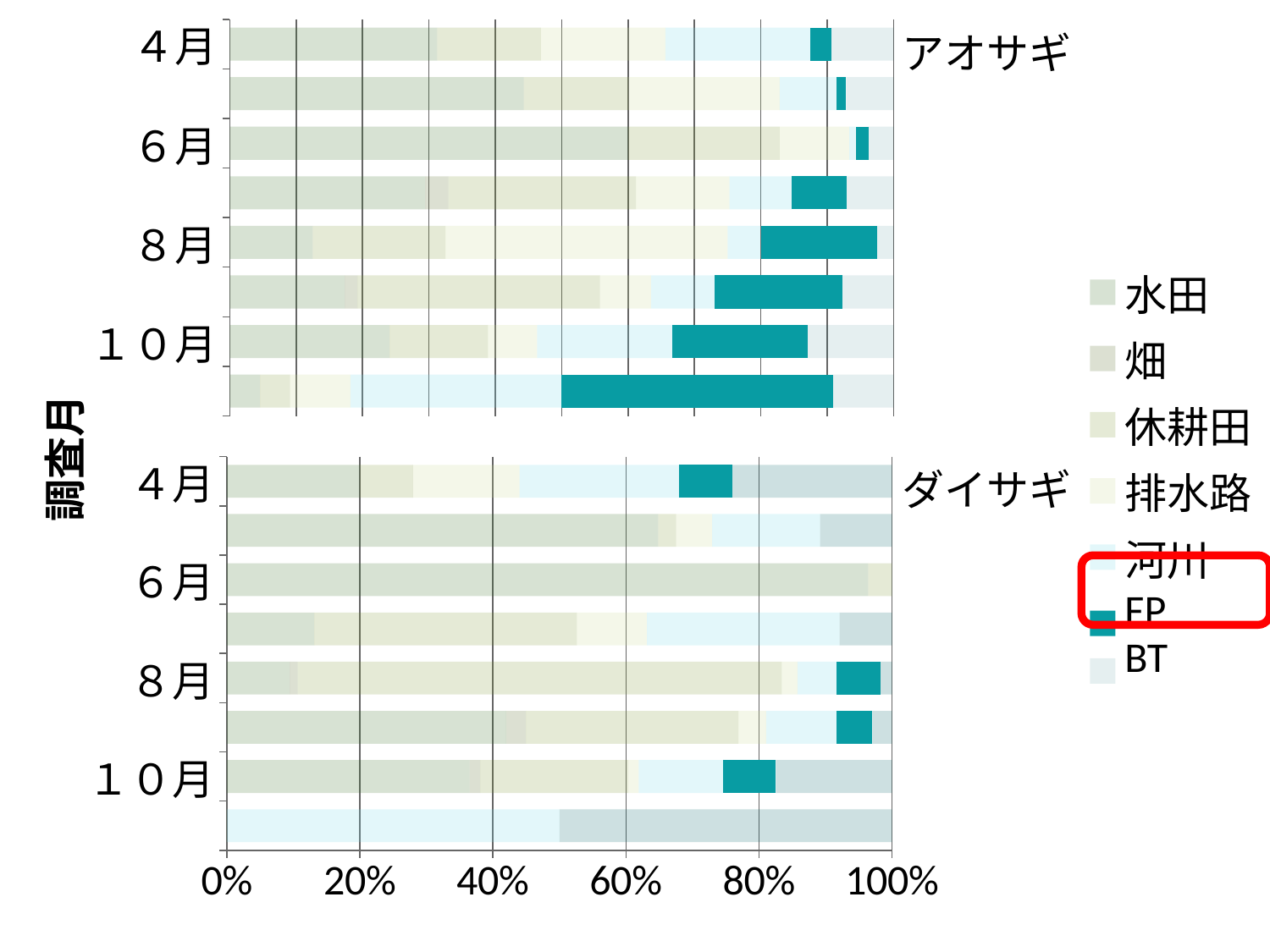
In the アオサギ chart, does the FP segment grow or shrink going down the bars from 6月 to the bottom bar? grow In the ダイサギ chart, is the 水田 share larger in 4月 or in 6月? 6月 How many bars are plotted in the ダイサギ chart? 8 What is the title of the vertical axis shared by the two charts? 調査月 In the ダイサギ chart, is the 水田 share for 6月 greater or less than 20%? greater What kind of chart is used for the アオサギ and ダイサギ panels? stacked bar chart How many bars are plotted in the アオサギ chart? 8 How many series does the legend list? 7 In the アオサギ chart, is the FP segment larger in 4月 or in 8月? 8月 In the アオサギ chart, is the 水田 share for 4月 greater or less than 20%? greater In the ダイサギ chart, is the 水田 share for 10月 greater or less than 20%? greater